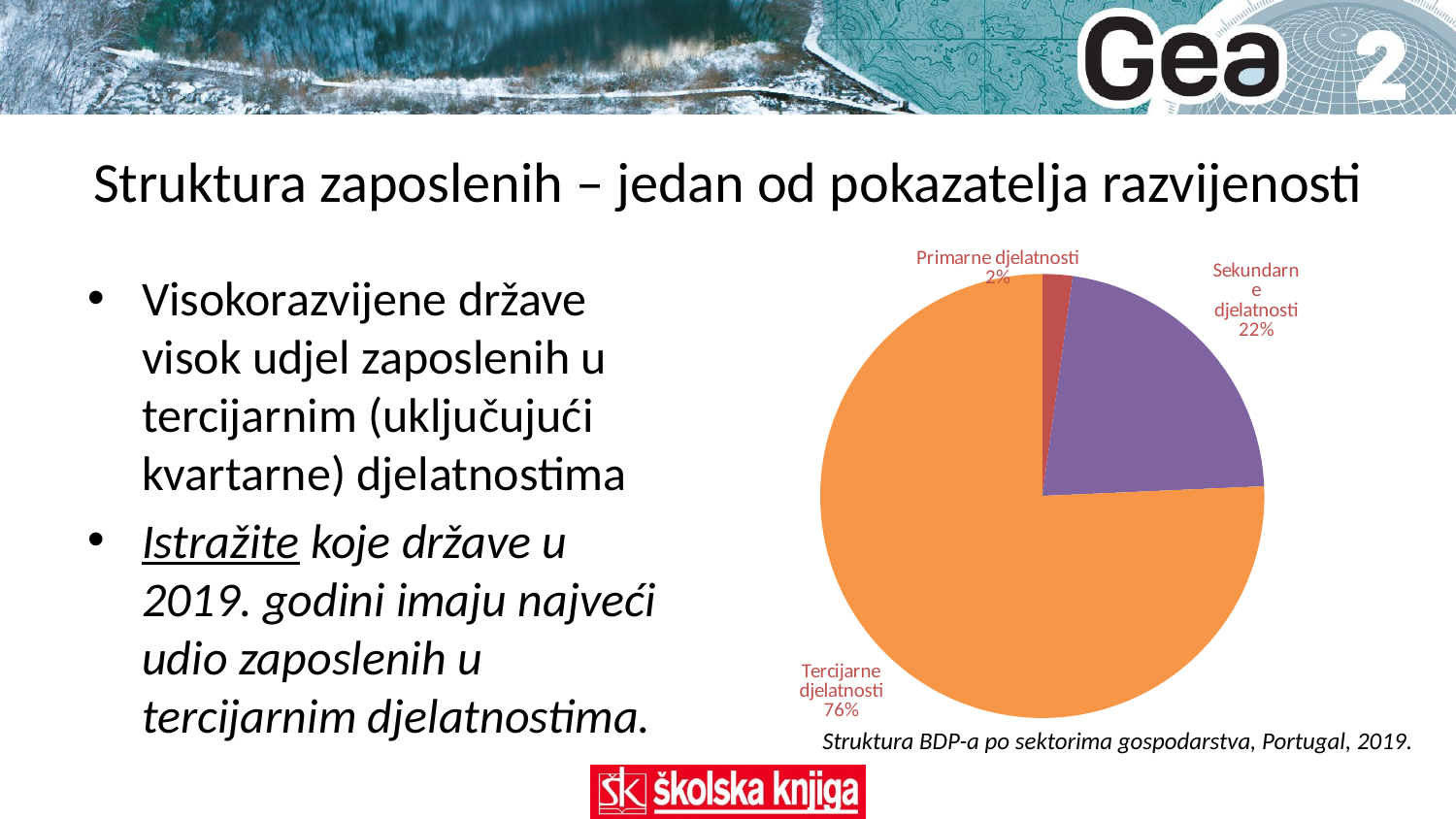
Which is larger, the share for Sekundarne djelatnosti or the share for Primarne djelatnosti? Sekundarne djelatnosti What is the caption of the pie chart? Struktura BDP-a po sektorima gospodarstva, Portugal, 2019. Which sector has the smallest slice of the pie? Primarne djelatnosti What is the combined share of Primarne djelatnosti and Sekundarne djelatnosti? 24% What share of the pie does Primarne djelatnosti have? 2% How many slices does the pie chart have? 3 What is the difference in percentage points between Tercijarne djelatnosti and Sekundarne djelatnosti? 54 What kind of chart is shown on the slide? pie chart What share of the pie does Tercijarne djelatnosti have? 76% What colour is the slice for Tercijarne djelatnosti? orange What share of the pie does Sekundarne djelatnosti have? 22% Which sector has the largest slice of the pie? Tercijarne djelatnosti